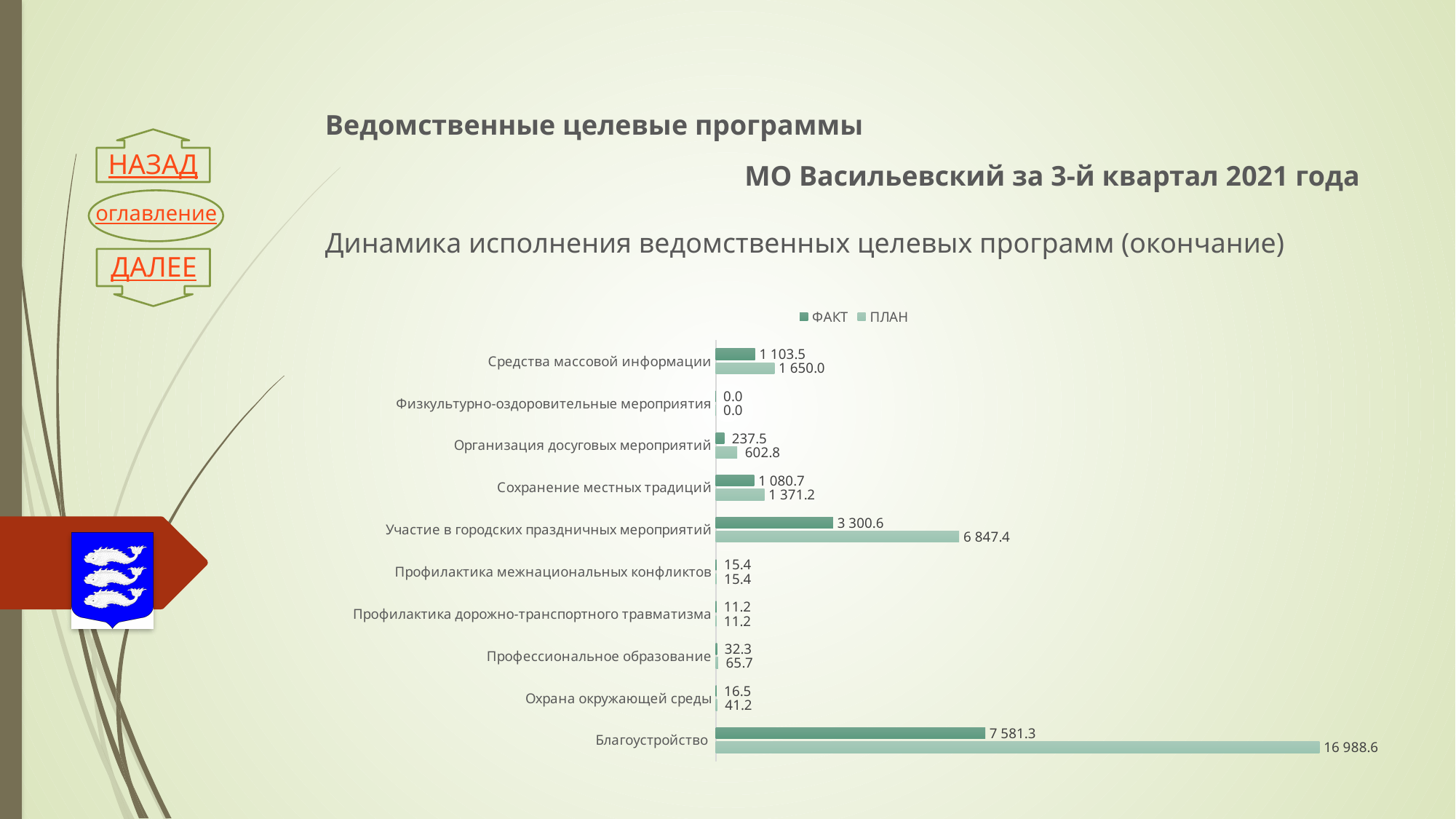
How many categories are shown on the chart? 10 What is the ФАКТ value for Благоустройство? 7 581.3 What is the ФАКТ value for Охрана окружающей среды? 16.5 What kind of chart is shown on the slide? Bar chart What is the difference between the ПЛАН and ФАКТ values for Средства массовой информации? 546.5 How many series does the legend list? 2 What is the difference between the ПЛАН and ФАКТ values for Благоустройство? 9 407.3 What is the ПЛАН value for Участие в городских праздничных мероприятий? 6 847.4 Which category has the lowest ФАКТ value? Физкультурно-оздоровительные мероприятия What is the ПЛАН value for Организация досуговых мероприятий? 602.8 Which is larger: the ФАКТ value for Сохранение местных традиций or the ФАКТ value for Средства массовой информации? Средства массовой информации Which category has the highest ПЛАН value? Благоустройство